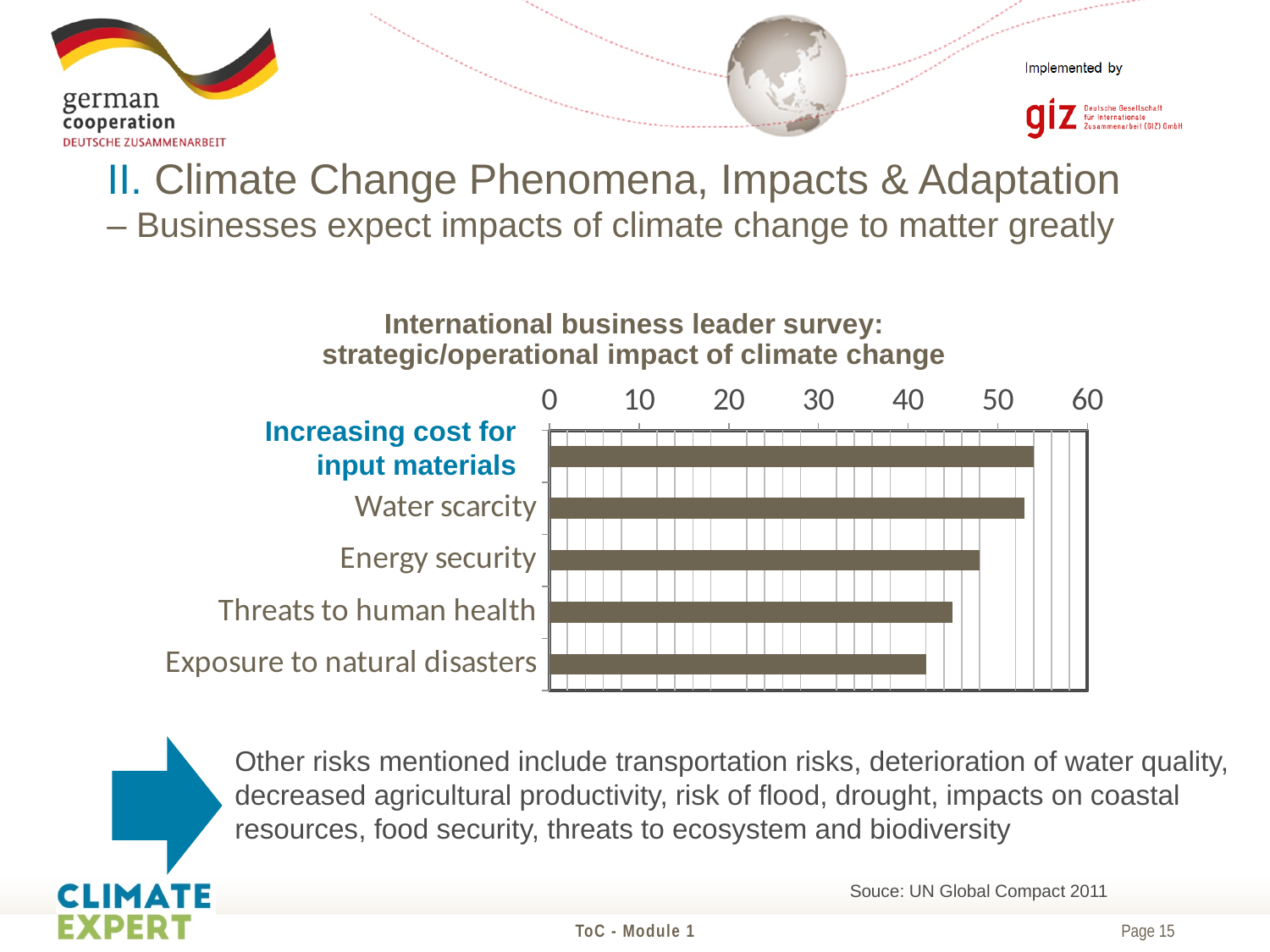
Is the value for Energy security greater or less than 50? less What is the title of the chart? International business leader survey: strategic/operational impact of climate change What is the highest value shown on the chart's axis? 60 Is the value for Exposure to natural disasters greater or less than 40? greater What kind of chart is shown on the slide? bar chart Is the value for Water scarcity greater or less than 50? greater Which is larger, the value for Water scarcity or the value for Threats to human health? Water scarcity How many categories are plotted in the chart? 5 Which category has the lowest value in the chart? Exposure to natural disasters Which is larger, the value for Energy security or the value for Exposure to natural disasters? Energy security